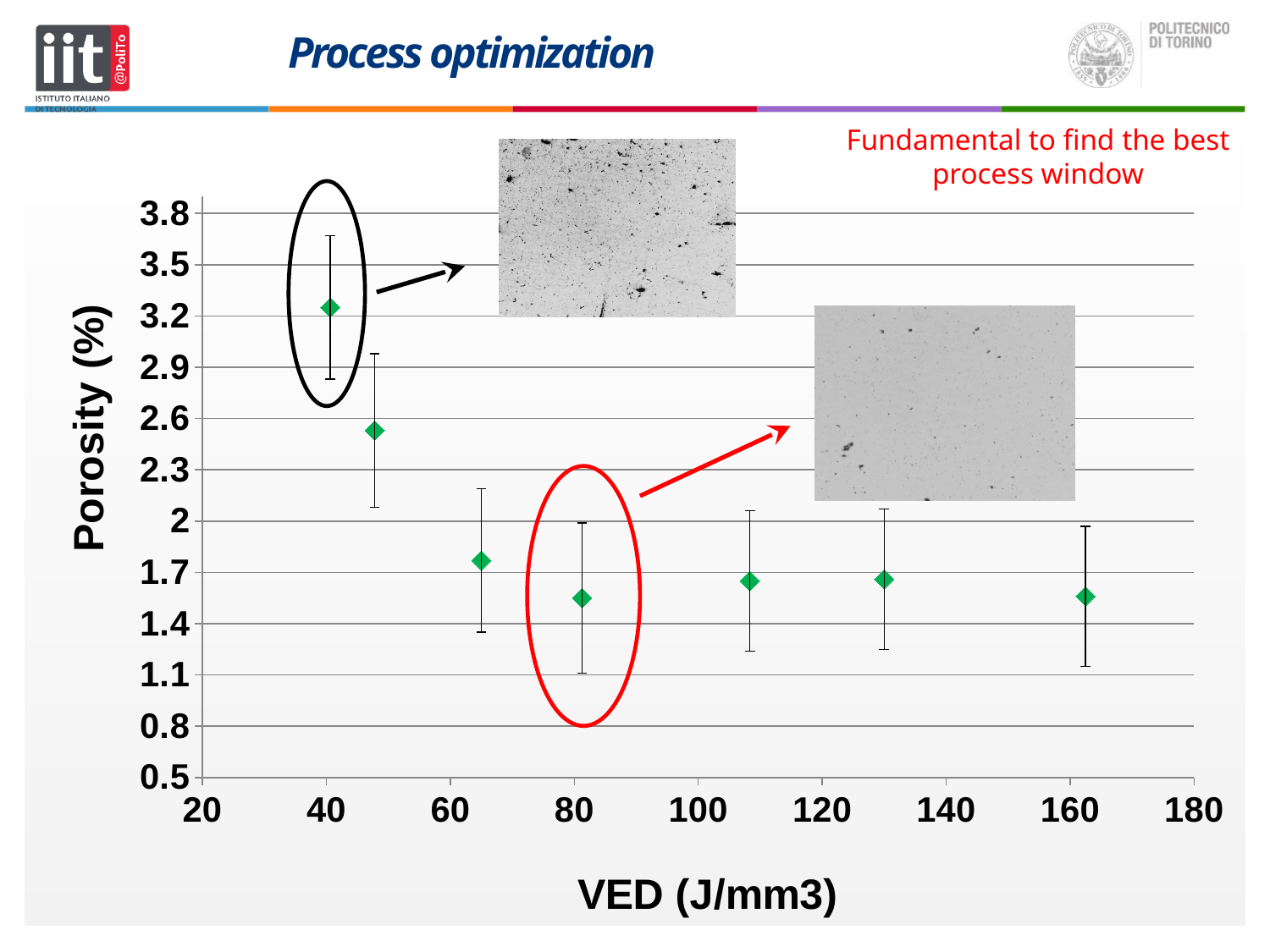
Is the porosity of the point circled in red greater or less than 1.7? less What is the label of the x axis? VED (J/mm3) Which has the higher porosity, the second point from the left or the third point from the left? The second point from the left How many data points are plotted on the chart? 7 What kind of chart is shown on the slide? Scatter chart Is the point with the highest porosity at the left end or the right end of the x axis? Left end Is the porosity of the rightmost point greater or less than 2? less Is the porosity of the leftmost point greater or less than 3? greater What is the label of the y axis? Porosity (%) Which has the higher porosity, the leftmost point or the rightmost point? The leftmost point Overall, does porosity rise or fall as VED increases along the x axis? Fall